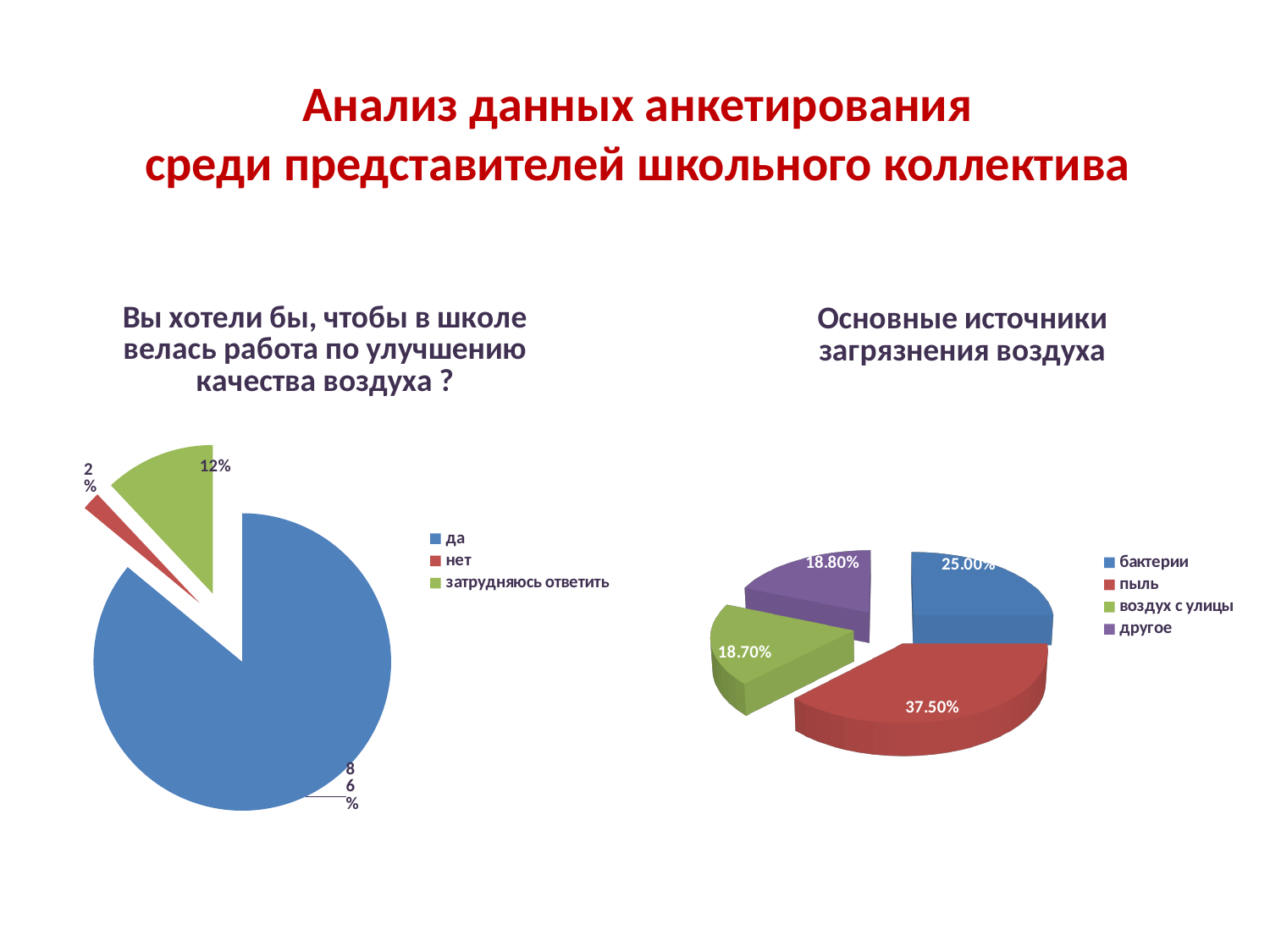
In the left chart ("Вы хотели бы, чтобы в школе велась работа по улучшению качества воздуха ?"), how many entries does the legend list? 3 In the right chart ("Основные источники загрязнения воздуха"), what share is attributed to "бактерии"? 25.00% In the right chart ("Основные источники загрязнения воздуха"), how many categories does the legend list? 4 In the right chart ("Основные источники загрязнения воздуха"), what share is attributed to "пыль"? 37.50% In the left chart ("Вы хотели бы, чтобы в школе велась работа по улучшению качества воздуха ?"), which answer has the smallest slice? нет In the left chart ("Вы хотели бы, чтобы в школе велась работа по улучшению качества воздуха ?"), which answer has the largest slice? да In the right chart ("Основные источники загрязнения воздуха"), which source has the largest slice? пыль In the left chart ("Вы хотели бы, чтобы в школе велась работа по улучшению качества воздуха ?"), what share of respondents answered "нет"? 2% In the left chart ("Вы хотели бы, чтобы в школе велась работа по улучшению качества воздуха ?"), what share answered "затрудняюсь ответить"? 12% In the left chart ("Вы хотели бы, чтобы в школе велась работа по улучшению качества воздуха ?"), what share of respondents answered "да"? 86% In the right chart ("Основные источники загрязнения воздуха"), what is the difference between the shares for "пыль" and "бактерии"? 12.50% What type of chart is the left chart titled "Вы хотели бы, чтобы в школе велась работа по улучшению качества воздуха ?"? pie chart